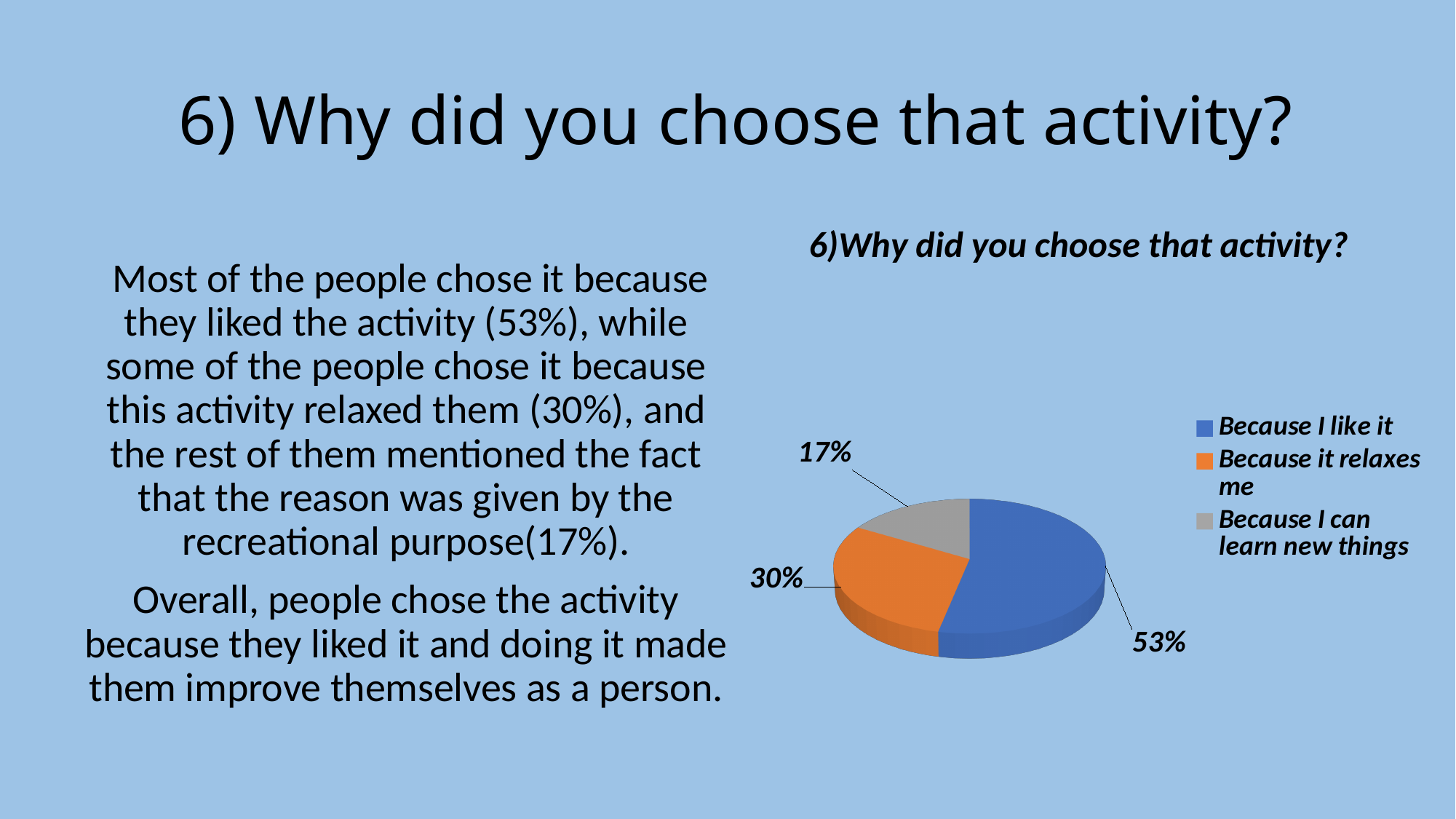
Which category has the smallest share of the pie? Because I can learn new things What percentage of the pie is 'Because I can learn new things'? 17% What percentage of the pie is 'Because it relaxes me'? 30% What kind of chart is shown on the slide? pie chart How many categories does the pie chart have? 3 What percentage of the pie is 'Because I like it'? 53% What is the difference in percentage points between 'Because it relaxes me' and 'Because I can learn new things'? 13 Which category has the largest share of the pie? Because I like it What is the difference in percentage points between 'Because I like it' and 'Because it relaxes me'? 23 What is the title of the chart? 6)Why did you choose that activity? Which colour represents 'Because it relaxes me' in the legend? orange Which is larger: the share for 'Because it relaxes me' or 'Because I can learn new things'? Because it relaxes me